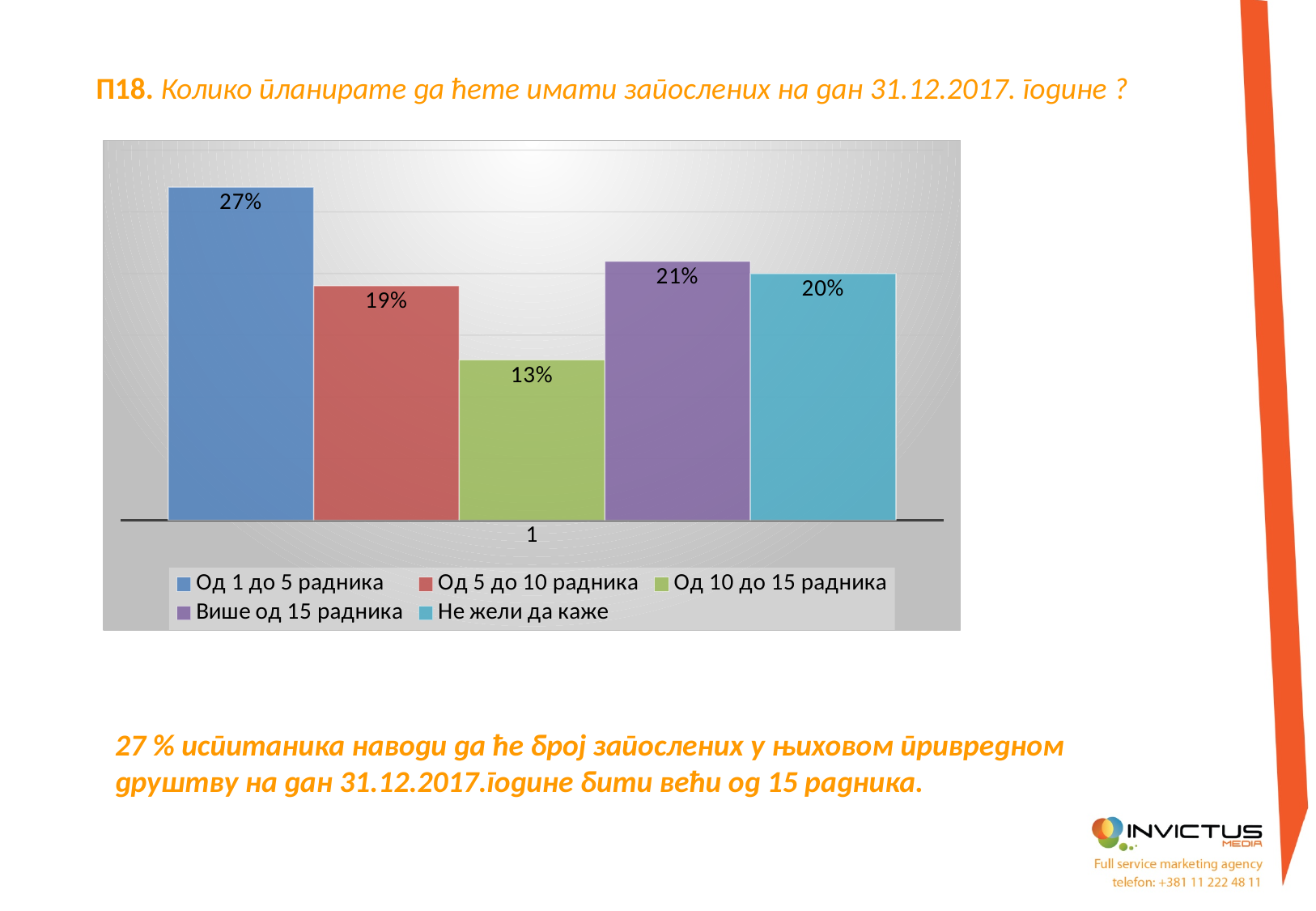
What value is shown for the series "Од 5 до 10 радника"? 19% What value is shown for the series "Не жели да каже"? 20% What value is shown for the series "Више од 15 радника"? 21% How many series does the legend list? 5 Which series has the lowest value in the chart? Од 10 до 15 радника What kind of chart is shown on the slide? Bar chart Which is larger, the value for "Од 5 до 10 радника" or the value for "Више од 15 радника"? Више од 15 радника What is the difference between the values for "Од 1 до 5 радника" and "Од 10 до 15 радника"? 14% Which series has the highest value in the chart? Од 1 до 5 радника What value is shown for the series "Од 1 до 5 радника"? 27% What value is shown for the series "Од 10 до 15 радника"? 13% What colour is the bar for "Не жели да каже"? Light blue (teal)